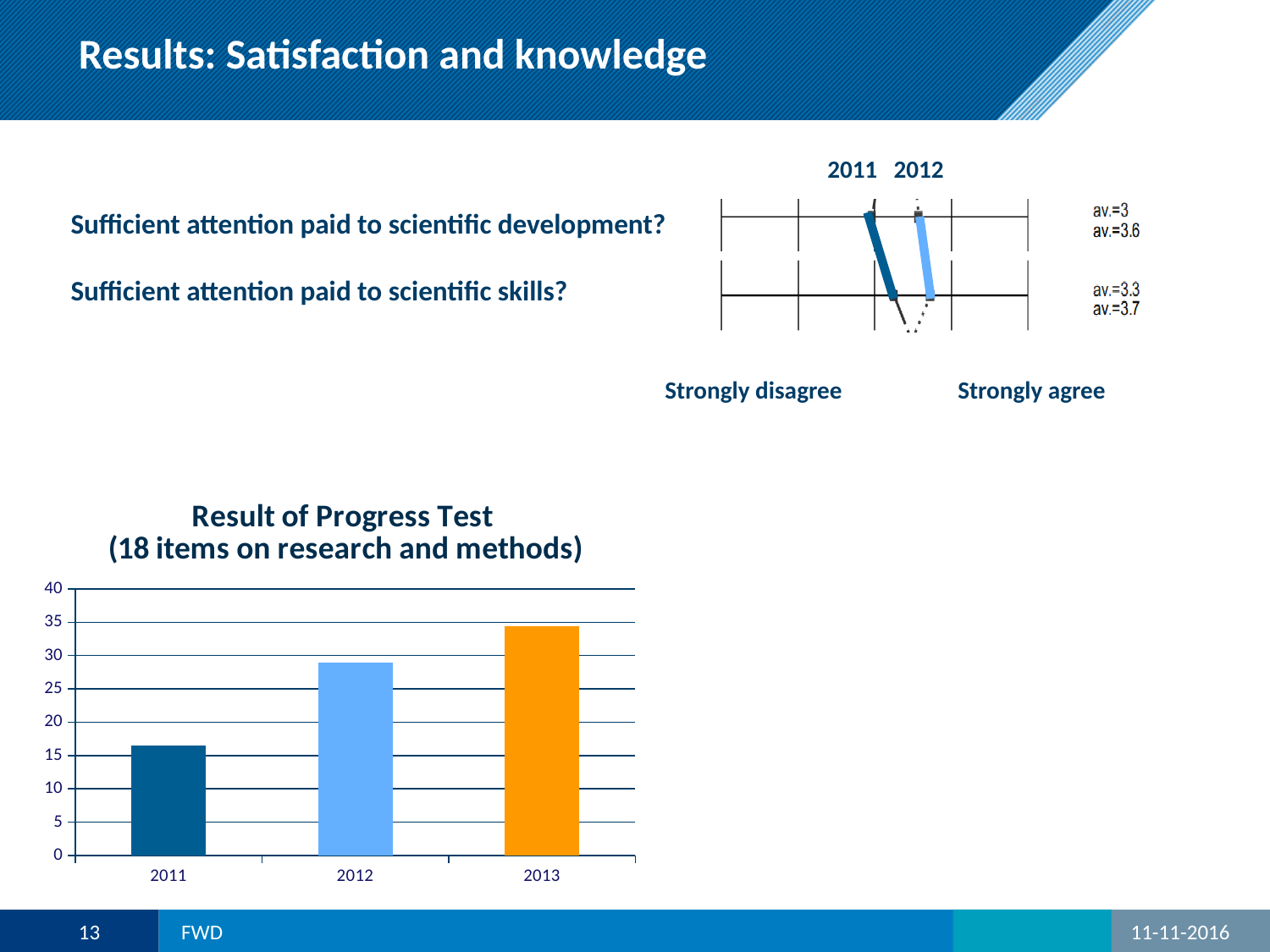
In the 'Result of Progress Test' chart, which is larger, the value for 2012 or the value for 2013? 2013 In the 'Result of Progress Test' chart, is the value for 2012 greater or less than 25? greater In the 'Result of Progress Test' chart, which year has the lowest value? 2011 How many bars are shown in the 'Result of Progress Test' chart? 3 In the 'Result of Progress Test' chart, do the values rise or fall from 2011 to 2013? rise In the 'Result of Progress Test' chart, is the value for 2011 greater or less than 20? less What is the subtitle in parentheses under 'Result of Progress Test'? (18 items on research and methods) What is the maximum value shown on the vertical axis of the 'Result of Progress Test' chart? 40 In the 'Result of Progress Test' chart, is the value for 2013 greater or less than 30? greater In the satisfaction chart at the top right, what are the two average values printed next to 'Sufficient attention paid to scientific skills?' av.=3.3 and av.=3.7 What kind of chart is the 'Result of Progress Test' chart? bar chart In the 'Result of Progress Test' chart, which year has the highest value? 2013